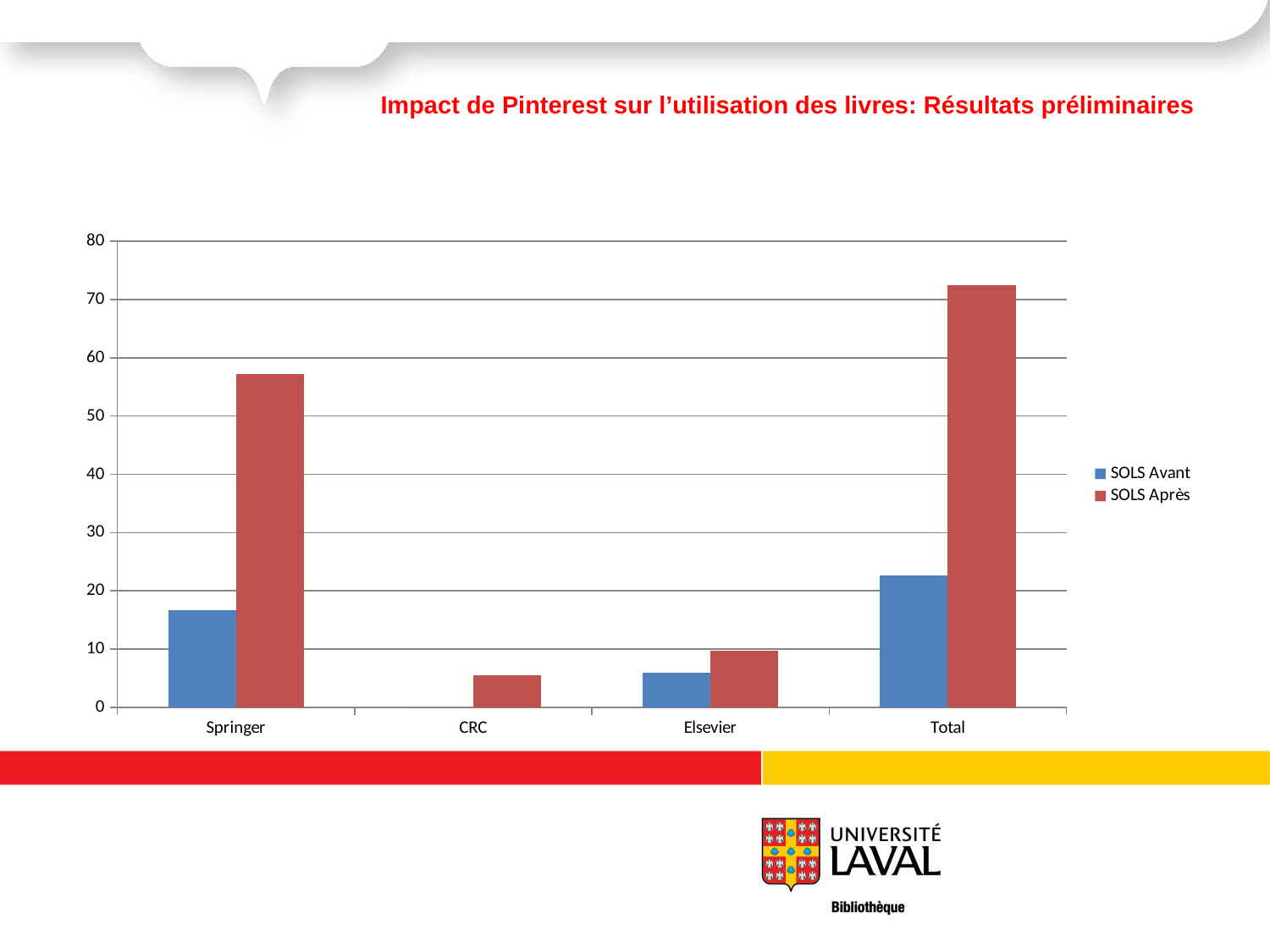
Is the SOLS Après value for Total greater or less than 70? greater Is the SOLS Après value for Springer greater or less than 50? greater Which series is shown in blue? SOLS Avant What is the title of the slide? Impact de Pinterest sur l'utilisation des livres: Résultats préliminaires For Springer, which is larger: SOLS Avant or SOLS Après? SOLS Après How many categories are shown on the x axis? 4 Which category has the highest SOLS Après value? Total How many series does the legend list? 2 Is the SOLS Avant value for Springer greater or less than 20? less What kind of chart is shown on the slide? bar chart Which category has the lowest SOLS Après value? CRC